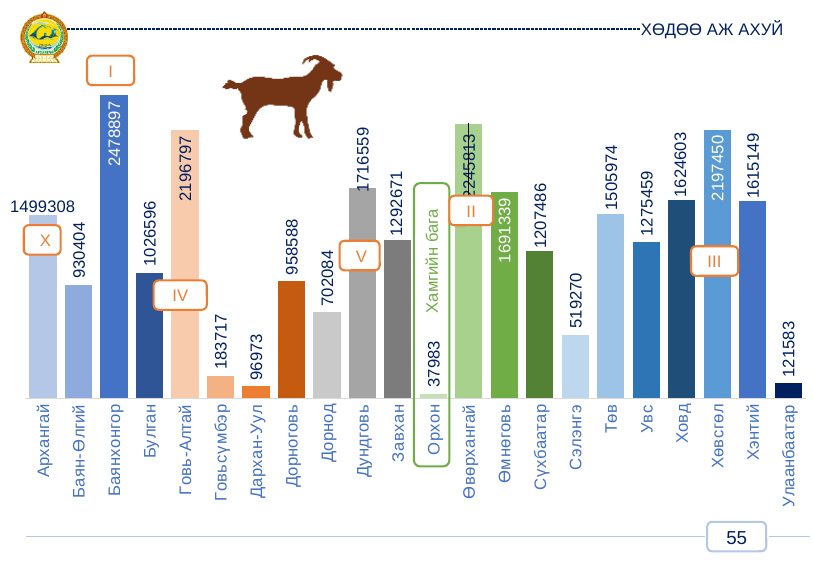
What is the difference between the values for Баянхонгор and Орхон? 2440914 Which province has the highest value on the chart? Баянхонгор Which is larger, the value for Дундговь or the value for Өмнөговь? Дундговь What is the value for Орхон? 37983 What type of chart is shown on the slide? bar chart Which province's bar is labelled "Хамгийн бага" on the chart? Орхон What is the value for Баянхонгор? 2478897 What is the value for Хөвсгөл? 2197450 What is the difference between the values for Хөвсгөл and Говь-Алтай? 653 What is the value for Улаанбаатар? 121583 How many provinces (categories) are shown on the chart? 22 Which province has the lowest value on the chart? Орхон